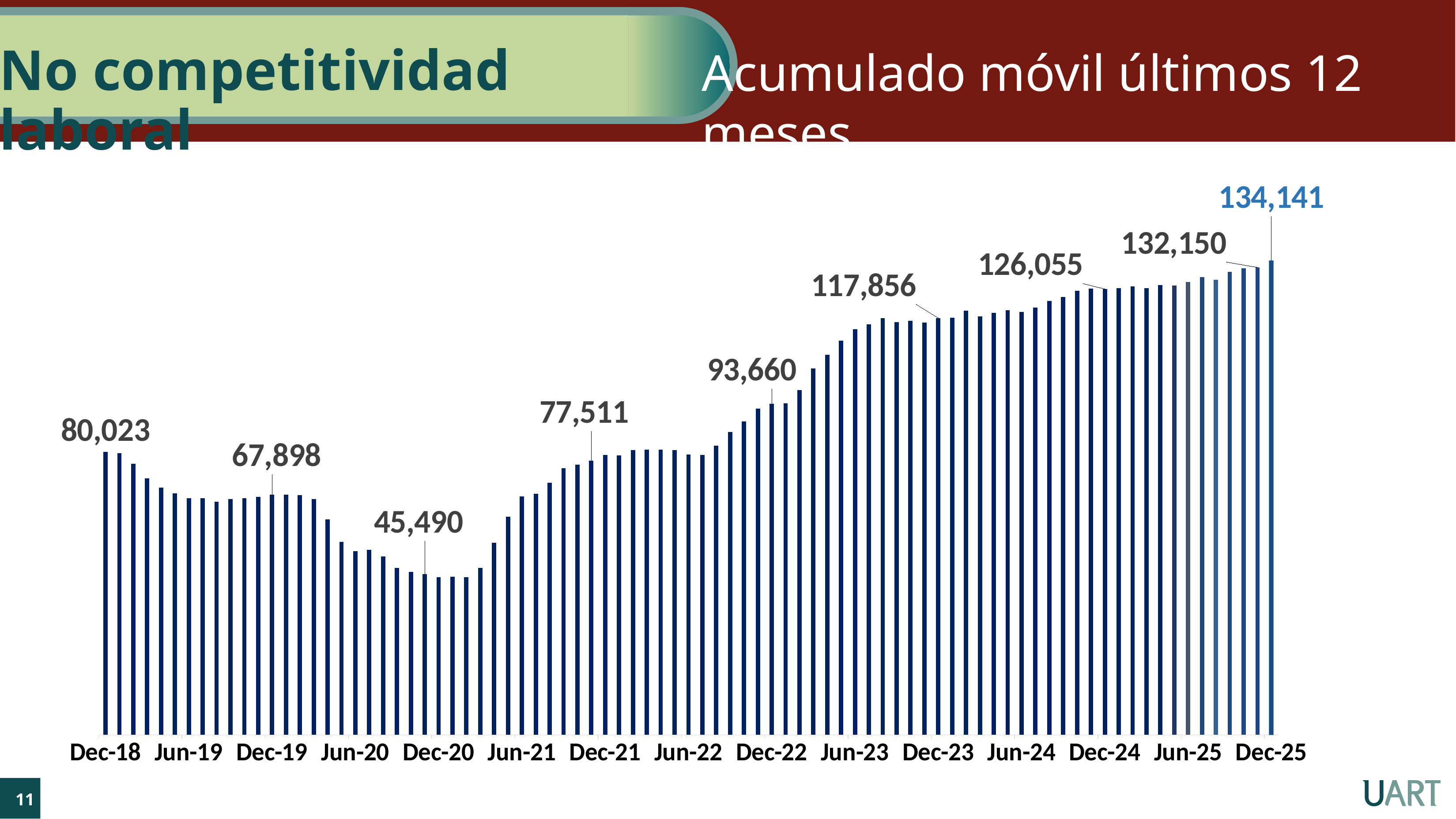
Which is larger, the value for Dec-19 or the value for Dec-21? Dec-21 What is the difference between the Dec-25 value (134,141) and the Dec-24 value (126,055)? 8,086 Which labelled month has the highest value? Dec-25 What is the value labelled on the final bar, Dec-25? 134,141 What is the value labelled for Dec-18? 80,023 What is the value labelled for Dec-19? 67,898 Do the values generally rise or fall from Dec-20 to Dec-25? rise What kind of chart is shown on the slide? bar chart What is the value labelled for Dec-22? 93,660 What is the value labelled for Dec-24? 126,055